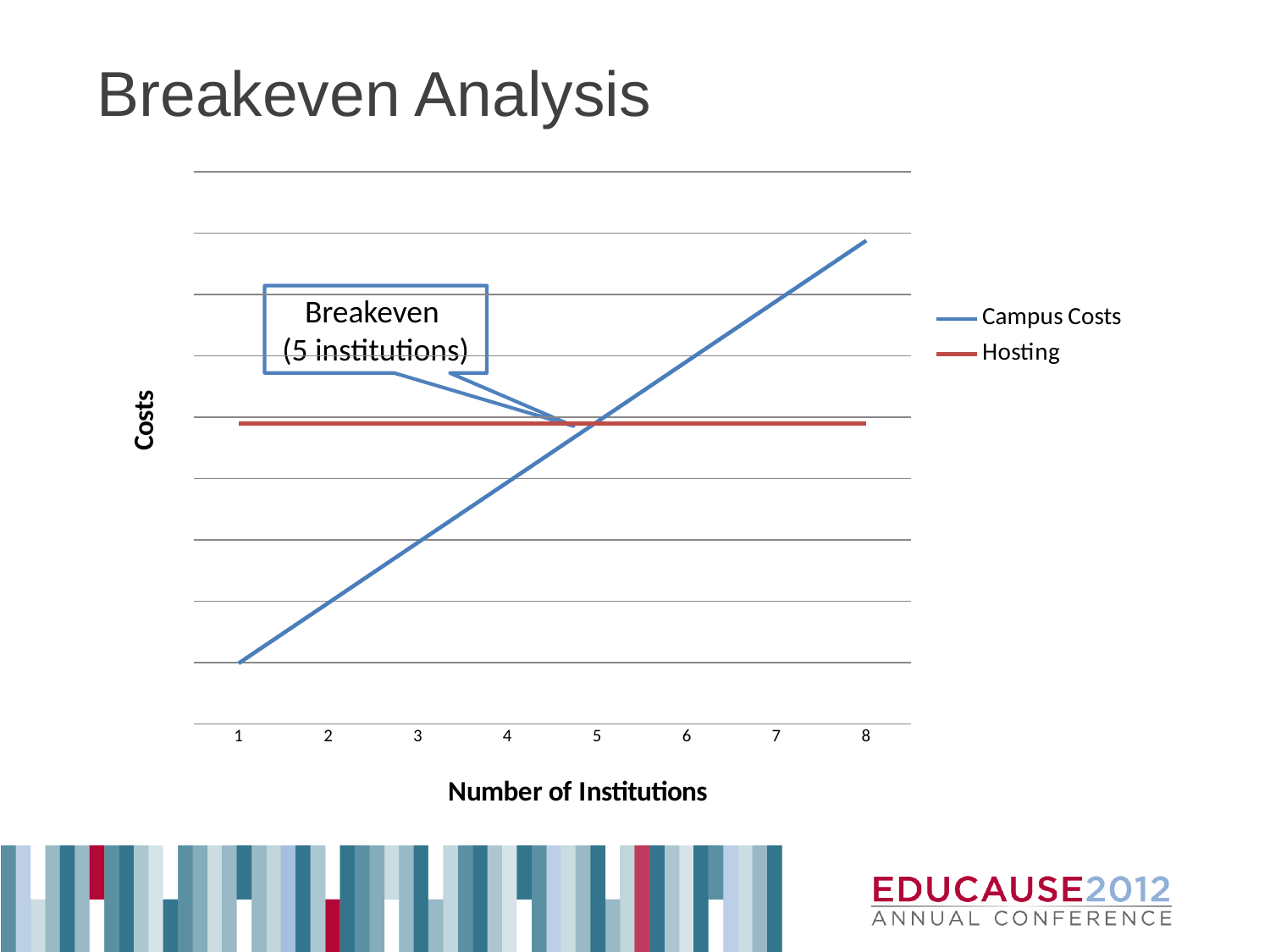
At how many institutions does the chart mark the breakeven point? 5 institutions What kind of chart is shown on the slide? Line chart Do Campus Costs rise or fall as the number of institutions increases? Rise At 8 institutions, which is higher: Campus Costs or Hosting? Campus Costs How many points are shown along the x axis (Number of Institutions)? 8 At 2 institutions, which is lower: Campus Costs or Hosting? Campus Costs How many series does the legend list? 2 At 1 institution, which is higher: Campus Costs or Hosting? Hosting Does the Hosting line rise, fall, or stay flat as the number of institutions increases? Stays flat What is the title of the x axis? Number of Institutions